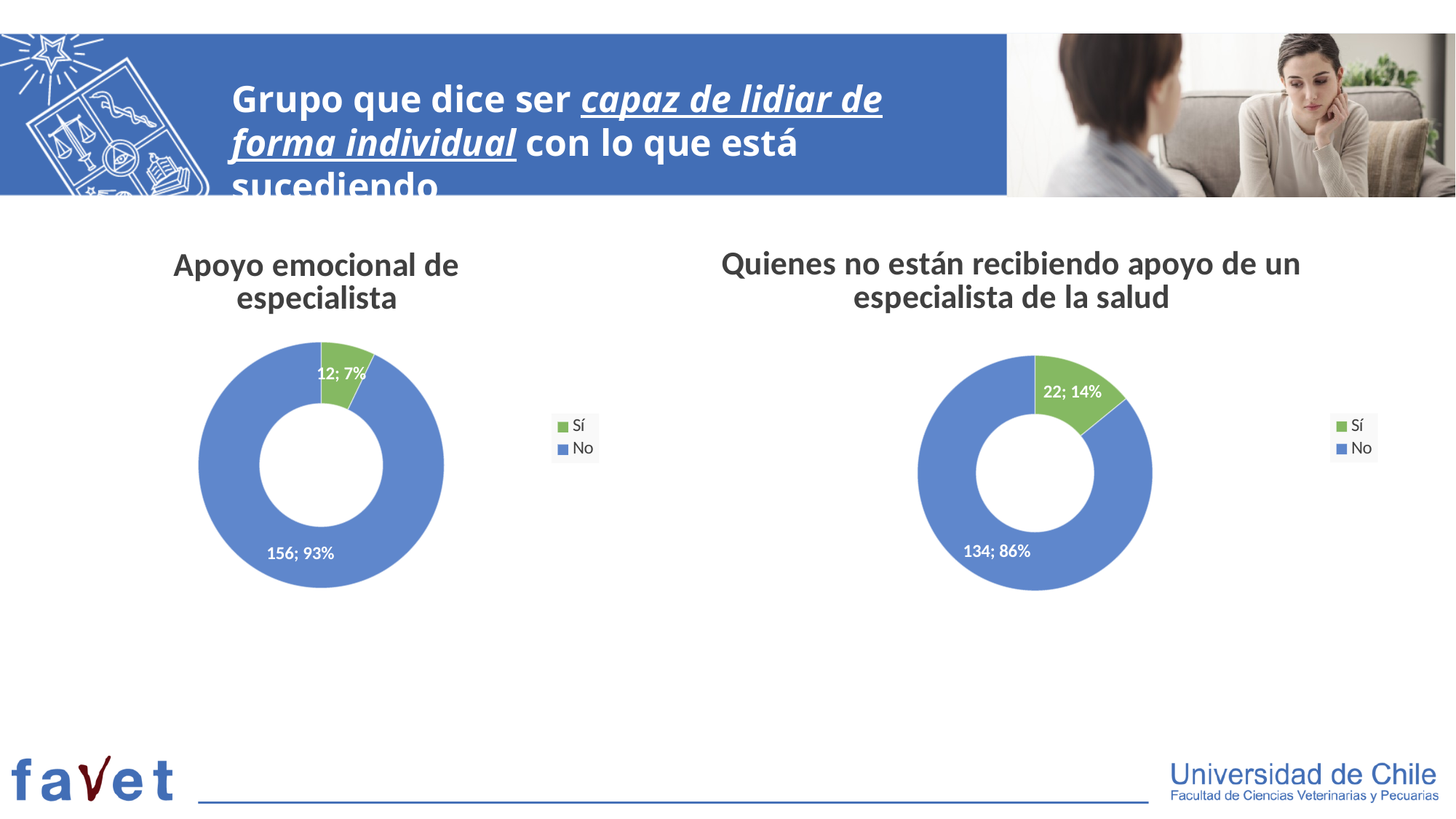
In the 'Apoyo emocional de especialista' chart, what is the count for 'Sí'? 12 In the 'Quienes no están recibiendo apoyo de un especialista de la salud' chart, what is the difference between the counts for 'No' and 'Sí'? 112 In the 'Quienes no están recibiendo apoyo de un especialista de la salud' chart, what percentage is shown for 'No'? 86% In the 'Apoyo emocional de especialista' chart, what percentage is shown for 'No'? 93% In the 'Apoyo emocional de especialista' chart, which category has the largest share? No Which is larger: the 'Sí' count in the 'Apoyo emocional de especialista' chart or the 'Sí' count in the 'Quienes no están recibiendo apoyo de un especialista de la salud' chart? Quienes no están recibiendo apoyo de un especialista de la salud In the 'Apoyo emocional de especialista' chart, what colour represents 'Sí'? Green What type of chart is 'Apoyo emocional de especialista'? Doughnut chart In the 'Quienes no están recibiendo apoyo de un especialista de la salud' chart, which category has the smallest share? Sí In the 'Apoyo emocional de especialista' chart, what is the difference between the counts for 'No' and 'Sí'? 144 How many categories does the legend of the 'Quienes no están recibiendo apoyo de un especialista de la salud' chart list? 2 In the 'Quienes no están recibiendo apoyo de un especialista de la salud' chart, what is the count for 'Sí'? 22